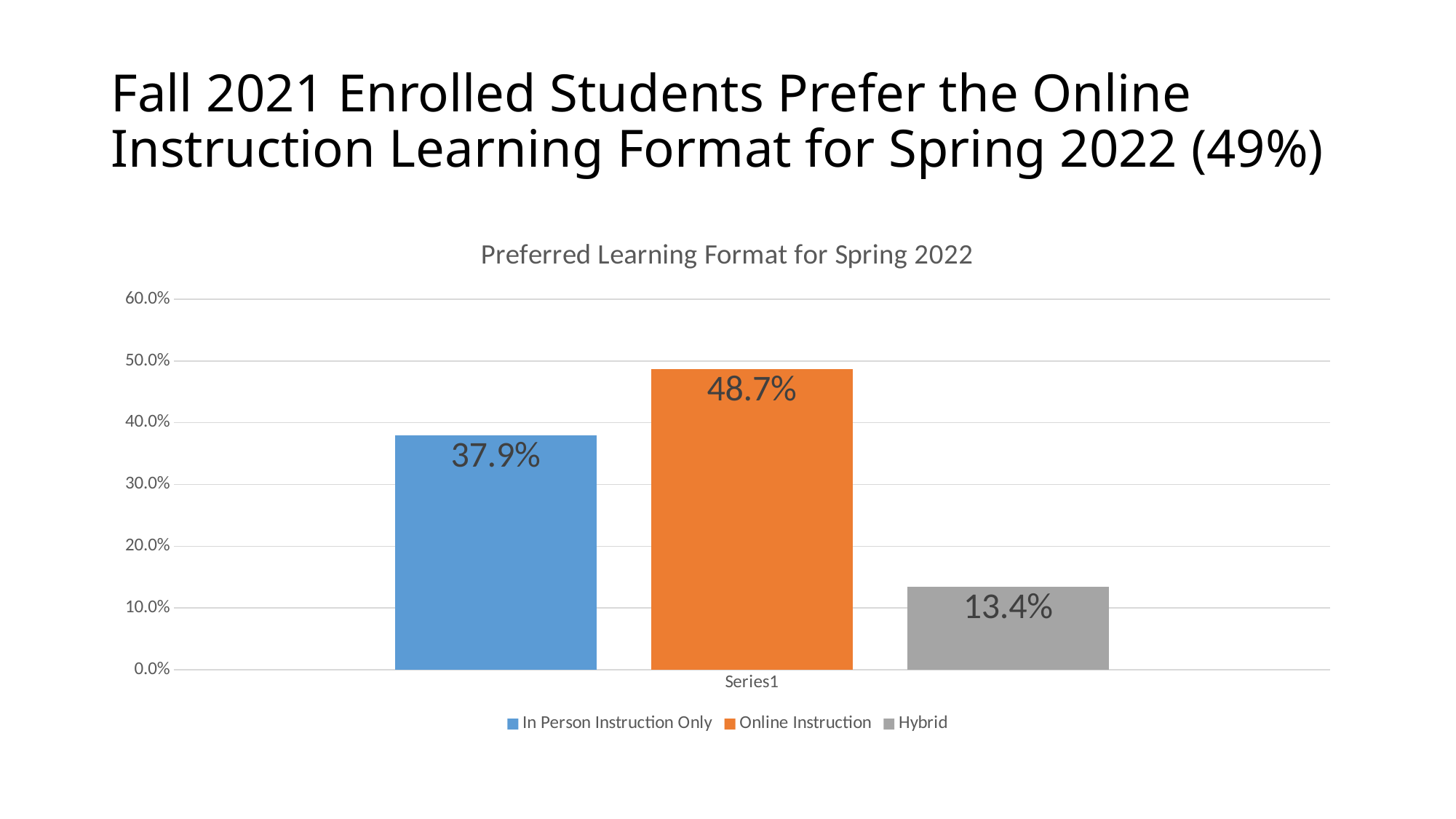
Which learning format has the highest value? Online Instruction What is the difference between the Online Instruction and In Person Instruction Only values? 10.8% How many series does the legend list? 3 Which is larger, the value for In Person Instruction Only or the value for Hybrid? In Person Instruction Only What kind of chart is shown on the slide? Bar chart What is the title of the chart? Preferred Learning Format for Spring 2022 What is the value for Online Instruction? 48.7% What is the difference between the In Person Instruction Only and Hybrid values? 24.5% Which learning format has the lowest value? Hybrid What is the value for Hybrid? 13.4% What is the value for In Person Instruction Only? 37.9% Is the value for Online Instruction greater or less than 40.0%? greater